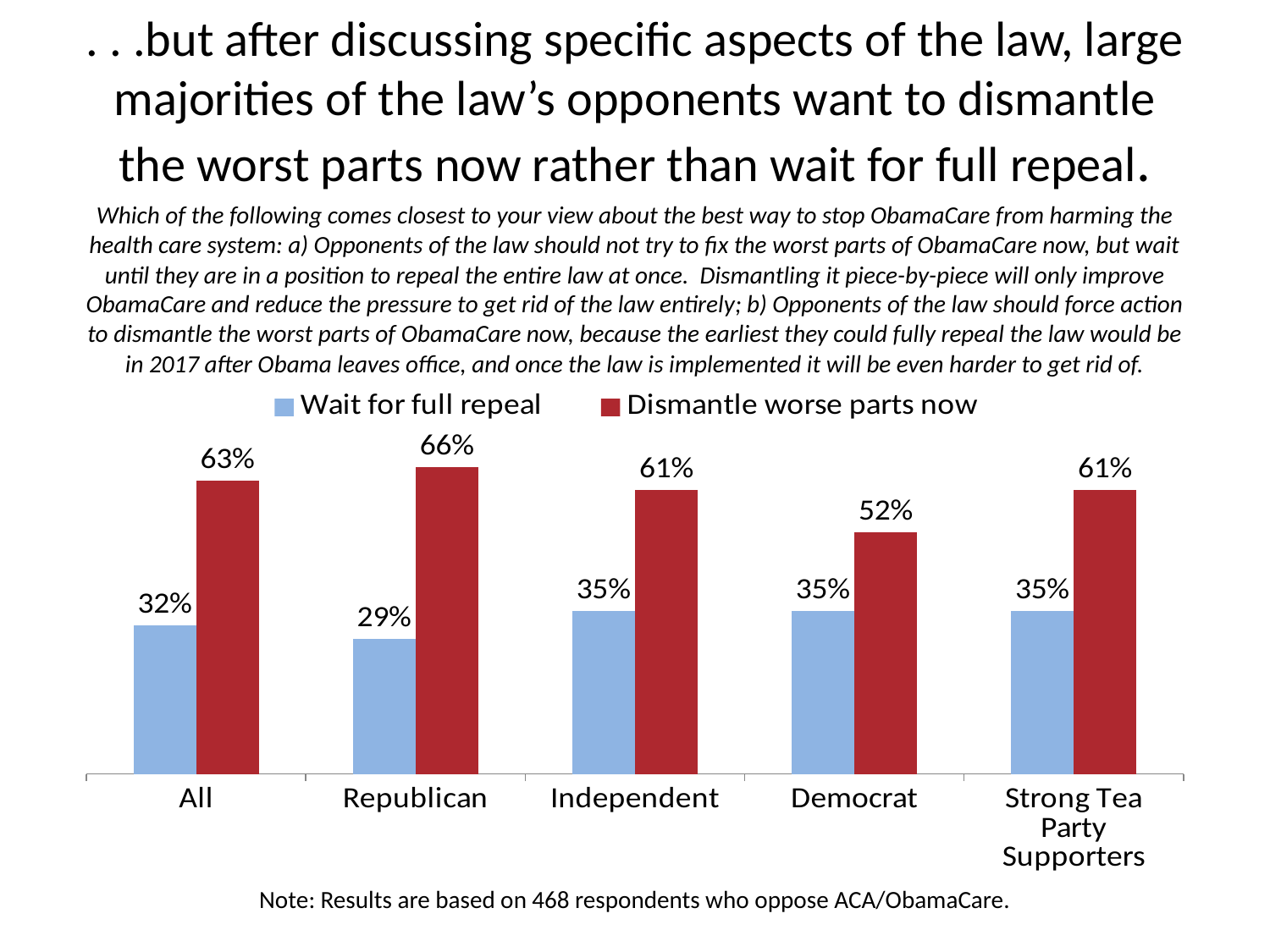
What percentage of Republicans chose "Dismantle worse parts now"? 66% Which category has the lowest "Dismantle worse parts now" value? Democrat Which category has the highest "Dismantle worse parts now" value? Republican How many series does the legend list? 2 What is the difference between the "Dismantle worse parts now" values for Independent and Democrat? 9 percentage points What kind of chart is shown on the slide? Bar chart What percentage of Democrats chose "Dismantle worse parts now"? 52% How many categories are shown on the x axis? 5 What is the "Wait for full repeal" value for the All category? 32% Which is larger for Democrats: "Wait for full repeal" or "Dismantle worse parts now"? Dismantle worse parts now What is the difference between the "Dismantle worse parts now" and "Wait for full repeal" values for Republicans? 37 percentage points Which category has the lowest "Wait for full repeal" value? Republican